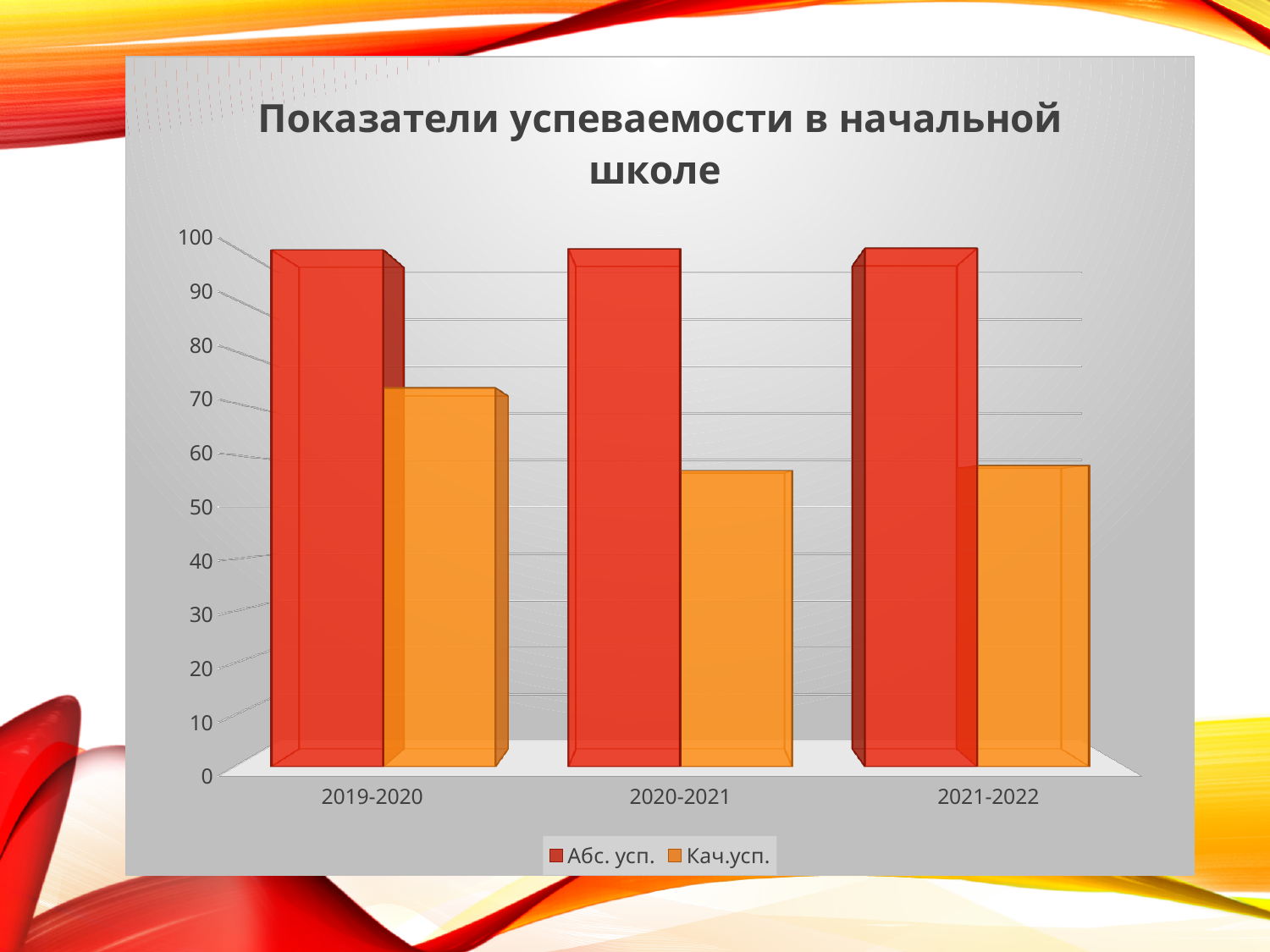
Is the value for Кач.усп. in 2019-2020 greater or less than 60? greater Which school year has the highest value for Кач.усп.? 2019-2020 Which is larger for Кач.усп.: the value in 2019-2020 or in 2020-2021? 2019-2020 How many series does the legend list? 2 Which series is shown in orange? Кач.усп. Does the value for Кач.усп. rise or fall from 2019-2020 to 2020-2021? fall Is the value for Кач.усп. in 2019-2020 greater or less than 80? less What type of chart is shown on the slide? Bar chart Is the value for Кач.усп. in 2020-2021 greater or less than 70? less How many categories (school years) are shown on the x axis? 3 What is the title of the chart? Показатели успеваемости в начальной школе